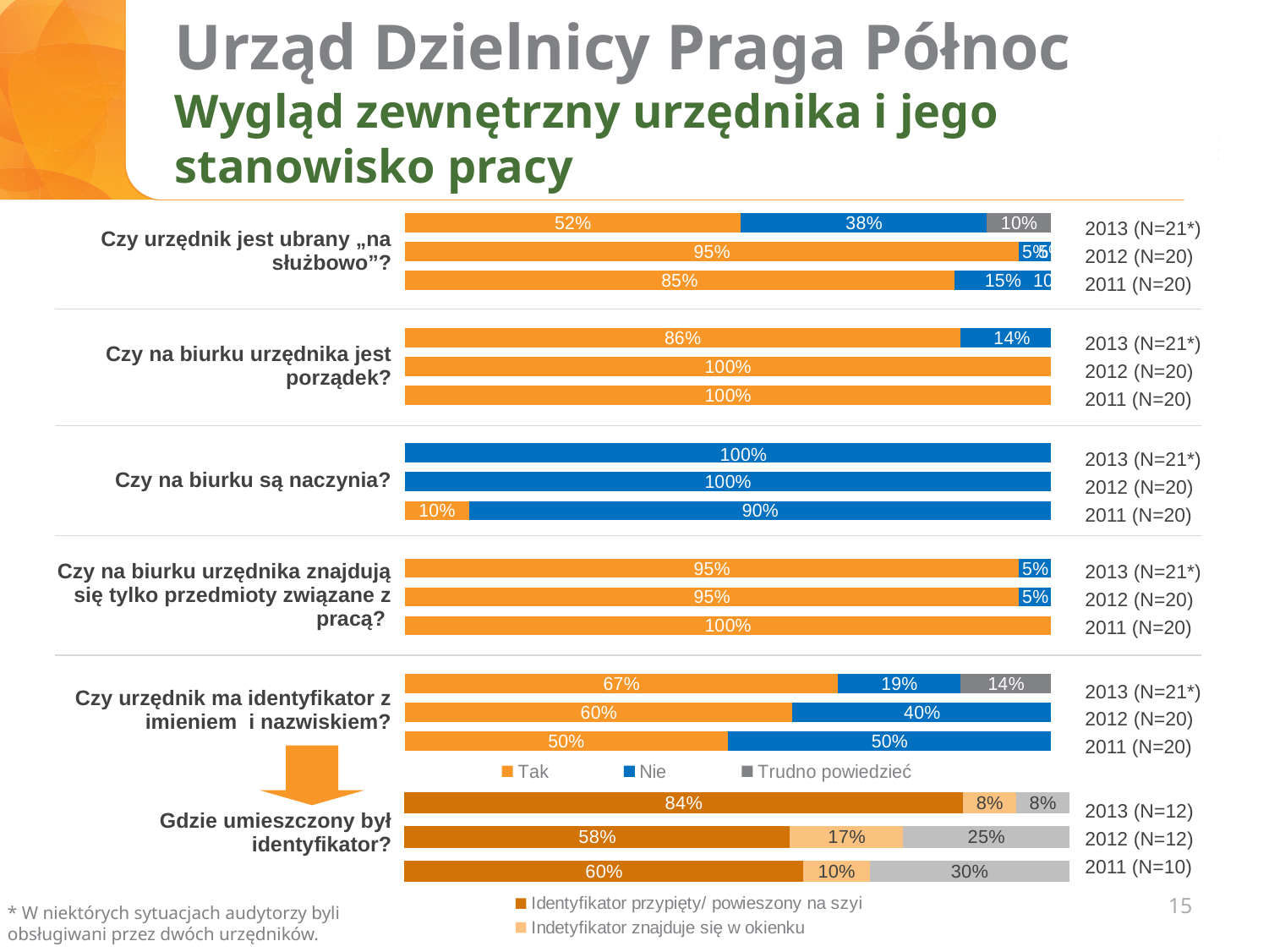
In the chart "Czy urzędnik ma identyfikator z imieniem i nazwiskiem?", what is the difference between the Tak share in 2013 and in 2011? 17% In the chart "Czy na biurku urzędnika jest porządek?", what percentage answered Nie in 2013 (N=21*)? 14% In the chart "Czy urzędnik jest ubrany „na służbowo”?", what percentage answered Tak in 2013 (N=21*)? 52% What kind of chart is used for "Czy na biurku są naczynia?"? Stacked bar chart How many series does the legend list for the chart "Czy urzędnik ma identyfikator z imieniem i nazwiskiem?"? 3 In the chart "Czy na biurku urzędnika znajdują się tylko przedmioty związane z pracą?", which year has the highest Tak share? 2011 (N=20) In the chart "Czy urzędnik ma identyfikator z imieniem i nazwiskiem?", which year has the lowest Tak share? 2011 (N=20) In the chart "Gdzie umieszczony był identyfikator?", what percentage had the identifier in the window (Indetyfikator znajduje się w okienku) in 2012 (N=12)? 17% In the chart "Czy urzędnik jest ubrany „na służbowo”?", what percentage answered Nie in 2013 (N=21*)? 38% In the chart "Czy na biurku są naczynia?", what percentage answered Tak in 2011 (N=20)? 10% In the chart "Gdzie umieszczony był identyfikator?", what percentage had the identifier pinned/hung on the neck (Identyfikator przypięty/ powieszony na szyi) in 2013 (N=12)? 84% In the chart "Czy urzędnik ma identyfikator z imieniem i nazwiskiem?", is the Nie share larger in 2012 or in 2013? 2012